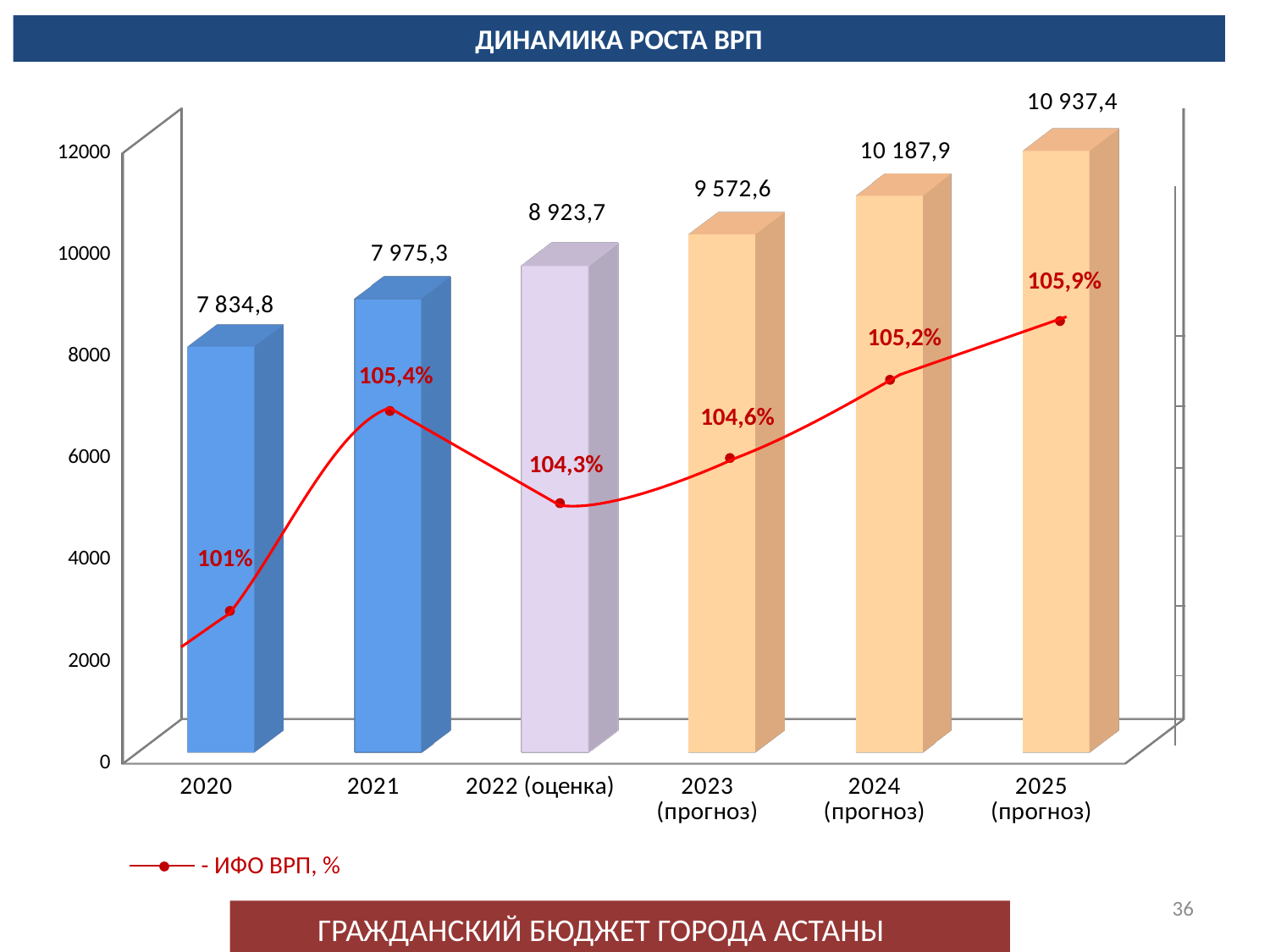
Which year has the highest ВРП bar? 2025 (прогноз) What is the ИФО ВРП, % value for 2022 (оценка)? 104,3% What is the ВРП value shown for 2025 (прогноз)? 10 937,4 Do the ВРП bar values rise or fall from 2020 to 2025 (прогноз)? rise What is the title of the chart? ДИНАМИКА РОСТА ВРП Which is larger, the ИФО ВРП, % value for 2021 or for 2023 (прогноз)? 2021 How many years are shown on the x axis? 6 Is the ВРП value for 2023 (прогноз) greater or less than 10000? less Which year has the lowest ИФО ВРП, % value? 2020 What is the ВРП value shown for 2021? 7 975,3 What is the ИФО ВРП, % value for 2020? 101% What is the difference between the ВРП values for 2025 (прогноз) and 2024 (прогноз)? 749,5